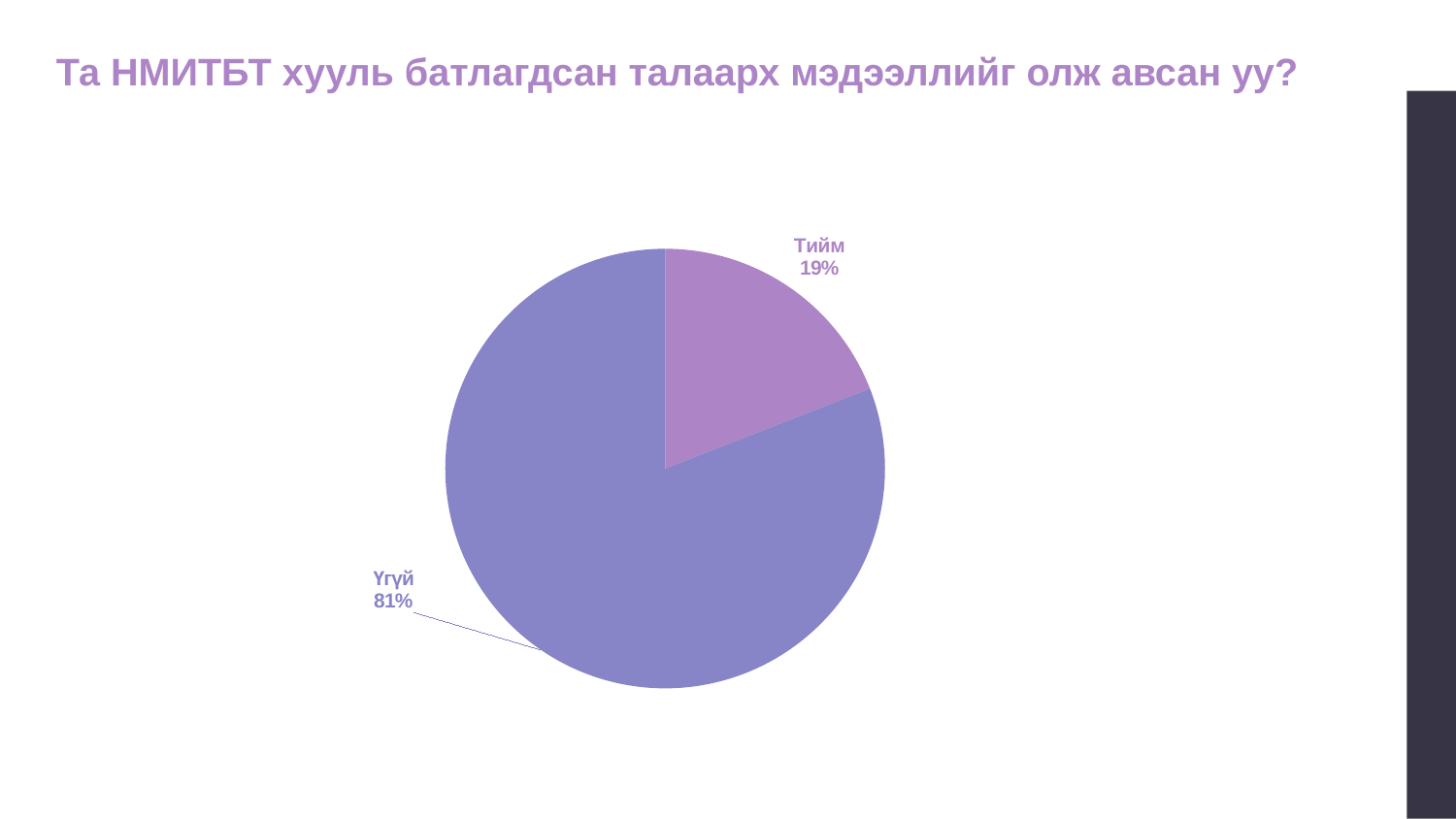
What is the title of the slide above the pie chart? Та НМИТБТ хууль батлагдсан талаарх мэдээллийг олж авсан уу? What kind of chart is shown on the slide? pie chart What share of the pie does the "Үгүй" slice represent? 81% What is the difference in percentage points between the "Үгүй" and "Тийм" slices? 62 What share of the pie does the "Тийм" slice represent? 19% How many slices does the pie chart have? 2 Which slice is the largest in the pie chart? Үгүй Which slice is the smallest in the pie chart? Тийм Which is larger, the "Тийм" slice or the "Үгүй" slice? Үгүй What is the total of the two slice percentages shown on the pie chart? 100%